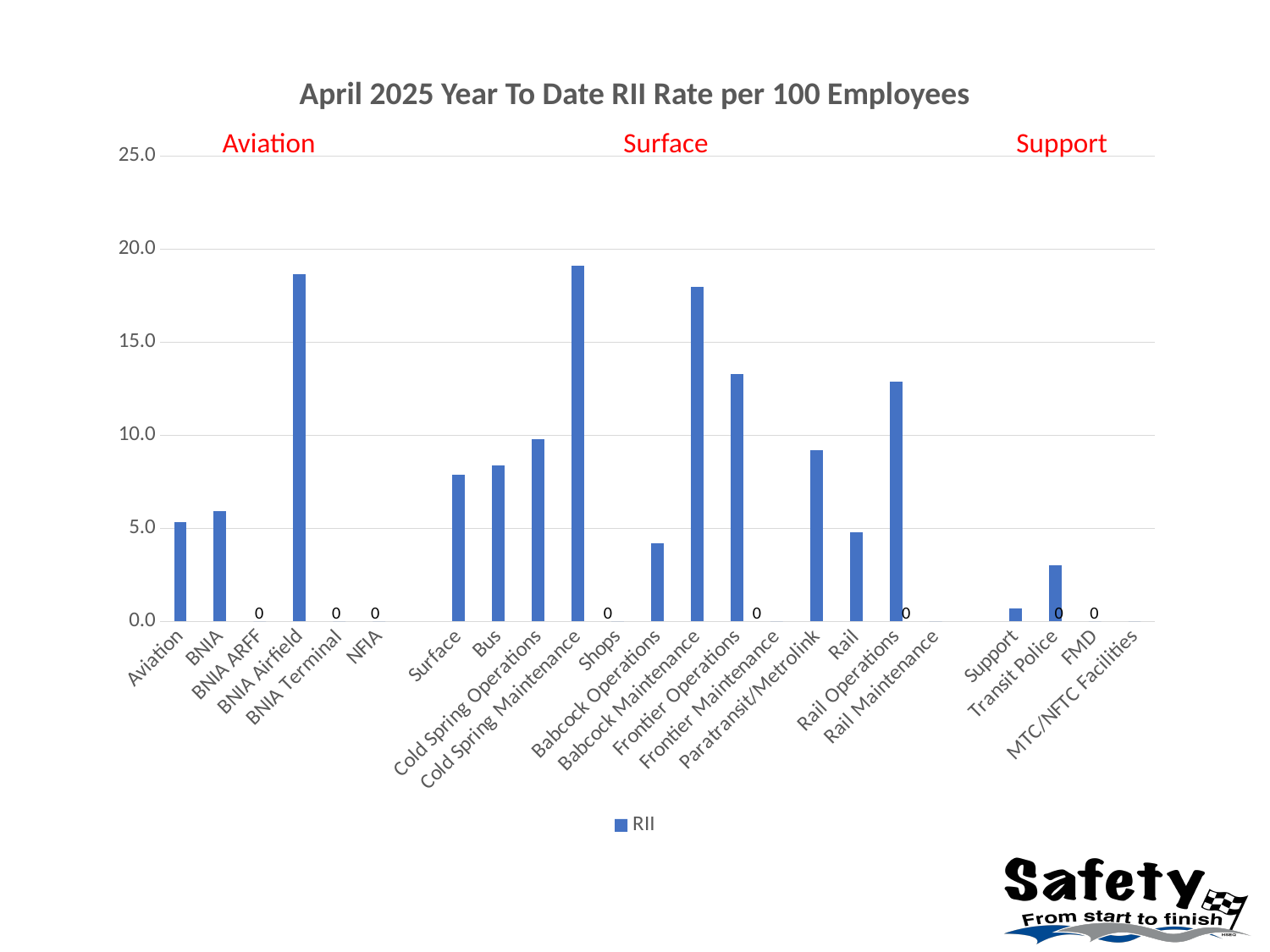
How many series does the legend list? 1 What is the RII rate for BNIA ARFF? 0 What kind of chart is shown on the slide? bar chart What is the title of the chart? April 2025 Year To Date RII Rate per 100 Employees Is the value for Frontier Operations greater or less than 10.0? greater What is the name of the series shown in the legend? RII Is the value for Babcock Operations greater or less than 5.0? less What is the RII rate for Shops? 0 What is the RII rate for NFIA? 0 How many categories are shown along the x axis? 23 Is the value for BNIA Airfield greater or less than 15.0? greater Which has the higher RII rate, Rail Operations or Rail? Rail Operations